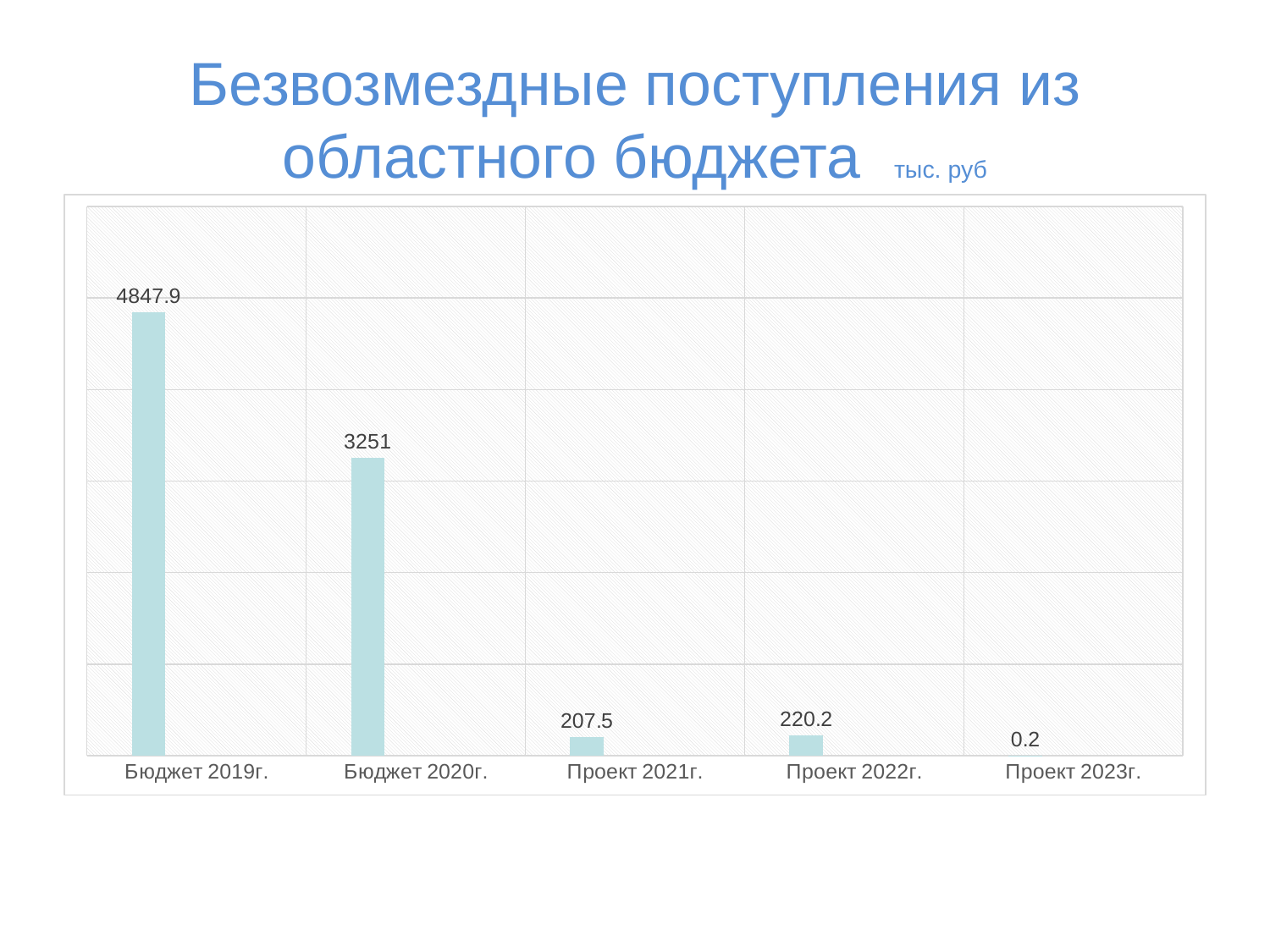
What is the value for Проект 2022г.? 220.2 What is the difference between the values for Бюджет 2019г. and Бюджет 2020г.? 1596.9 What kind of chart is shown on the slide? Bar chart Which category has the highest value? Бюджет 2019г. How many categories are shown on the x axis? 5 What is the value for Проект 2023г.? 0.2 What is the value for Бюджет 2020г.? 3251 Which category has the lowest value? Проект 2023г. What is the value for Проект 2021г.? 207.5 Which is larger, the value for Проект 2021г. or Проект 2022г.? Проект 2022г. What is the difference between the values for Проект 2022г. and Проект 2021г.? 12.7 What is the value for Бюджет 2019г.? 4847.9